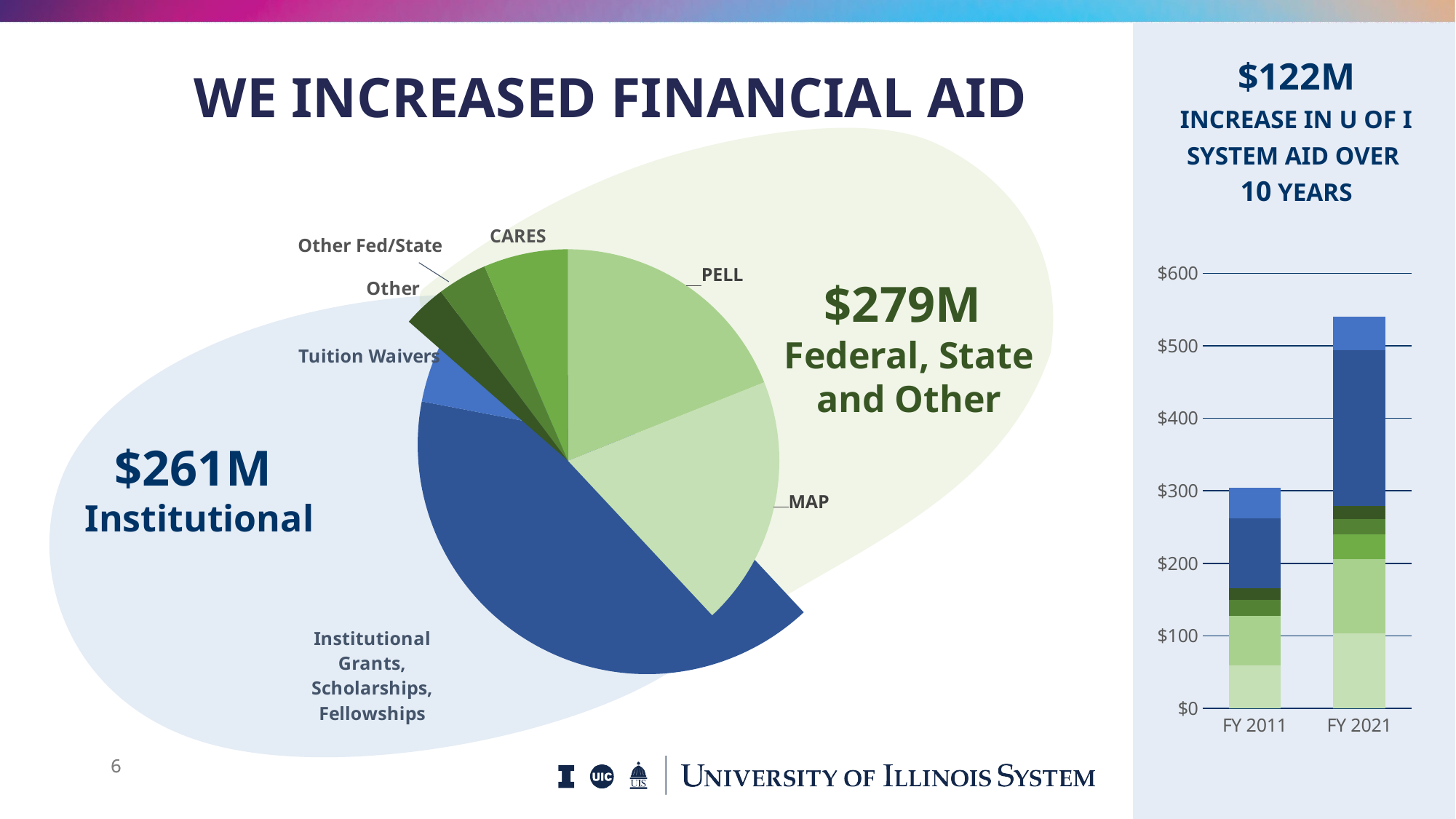
In the pie chart, what is the difference between the Federal, State and Other total and the Institutional total? $18M In the pie chart, which slice is the largest? Institutional Grants, Scholarships, Fellowships What kind of chart is the chart on the right of the slide, under the '$122M' heading? bar chart In the bar chart on the right, how many fiscal years are shown on the x axis? 2 In the pie chart, what is the total value of the Federal, State and Other group? $279M What kind of chart is the chart on the left of the slide? pie chart In the pie chart, which group is larger: Institutional or Federal, State and Other? Federal, State and Other In the pie chart, how many slices are labelled? 7 In the bar chart on the right, is the total for FY 2021 greater or less than $500? greater In the bar chart on the right, is the total for FY 2011 greater or less than $400? less In the pie chart, what is the total value of the Institutional group? $261M